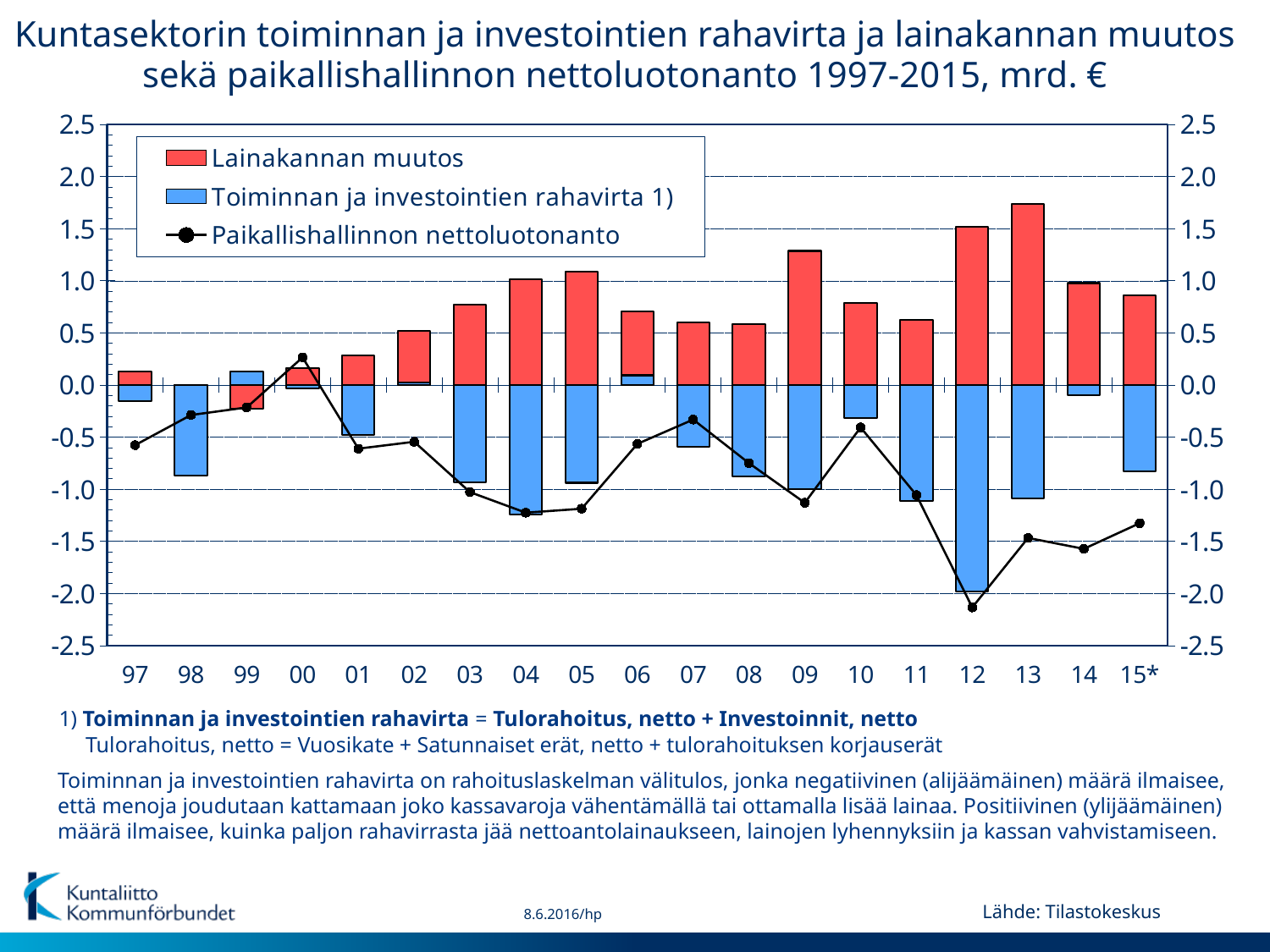
Is the Lainakannan muutos value for 13 greater or less than 1.5? greater In which year does the Paikallishallinnon nettoluotonanto line reach its lowest point? 12 Is the Paikallishallinnon nettoluotonanto value for 12 greater or less than -2.0? less How many series does the legend list? 3 Is the Lainakannan muutos value for 09 greater or less than 1.0? greater Which year has the larger Lainakannan muutos bar, 12 or 13? 13 How many years are shown on the x axis? 19 In which year is the Paikallishallinnon nettoluotonanto line at its highest point? 00 What kind of chart is shown on the slide? A combined bar and line chart Which series is shown as a line with markers in the legend? Paikallishallinnon nettoluotonanto In which year is the Lainakannan muutos bar the highest? 13